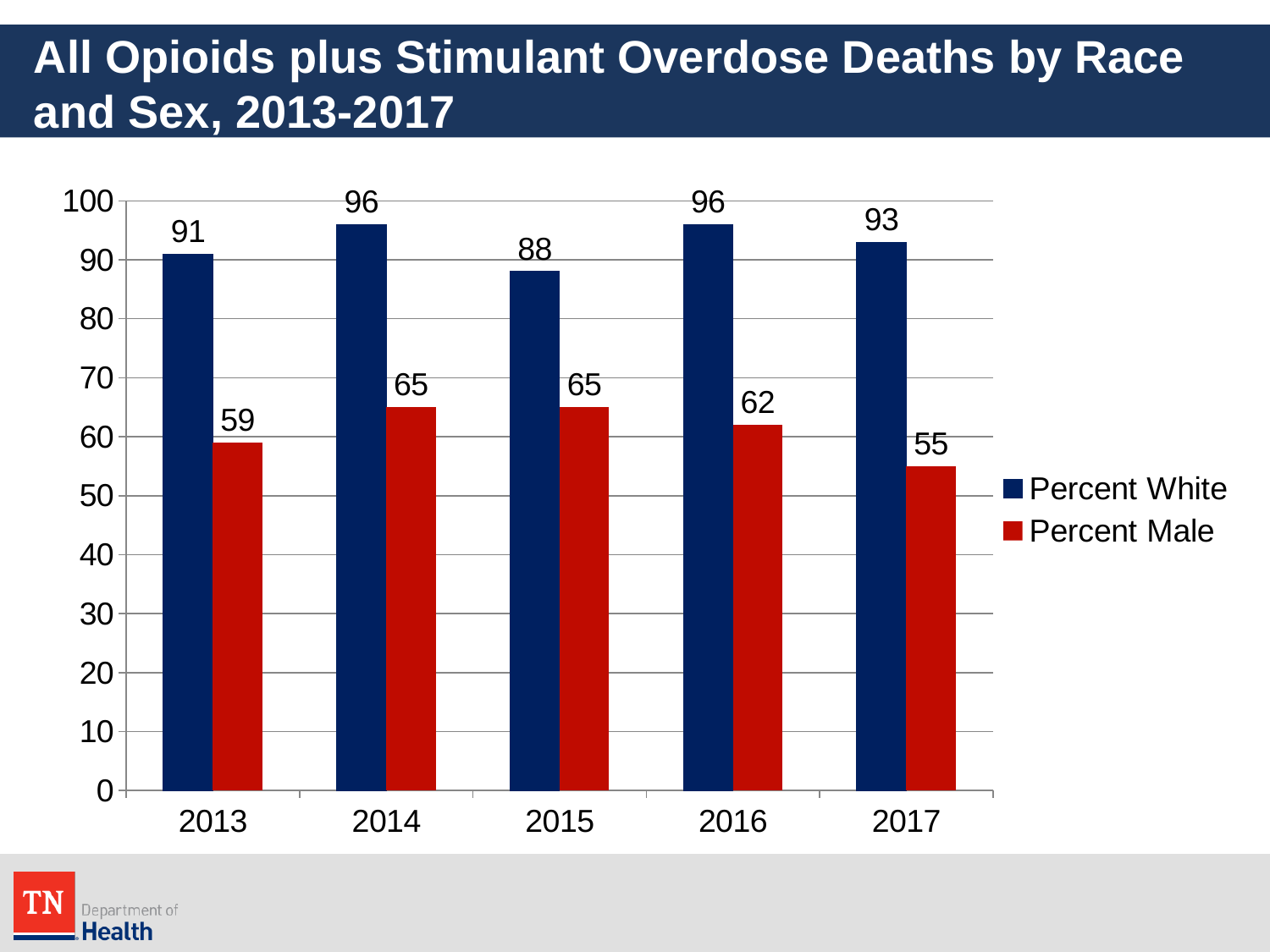
How many years are shown on the x axis? 5 Which is larger, the Percent Male value for 2016 or for 2013? 2016 What is the Percent Male value for 2013? 59 What is the Percent Male value for 2017? 55 Which year has the lowest Percent White value? 2015 What is the difference between Percent White and Percent Male in 2017? 38 What kind of chart is shown on the slide? Bar chart Is the Percent Male value for 2014 greater or less than 60? greater What is the difference between the Percent Male values for 2014 and 2017? 10 How many series does the legend list? 2 Which year has the lowest Percent Male value? 2017 What is the Percent White value for 2015? 88